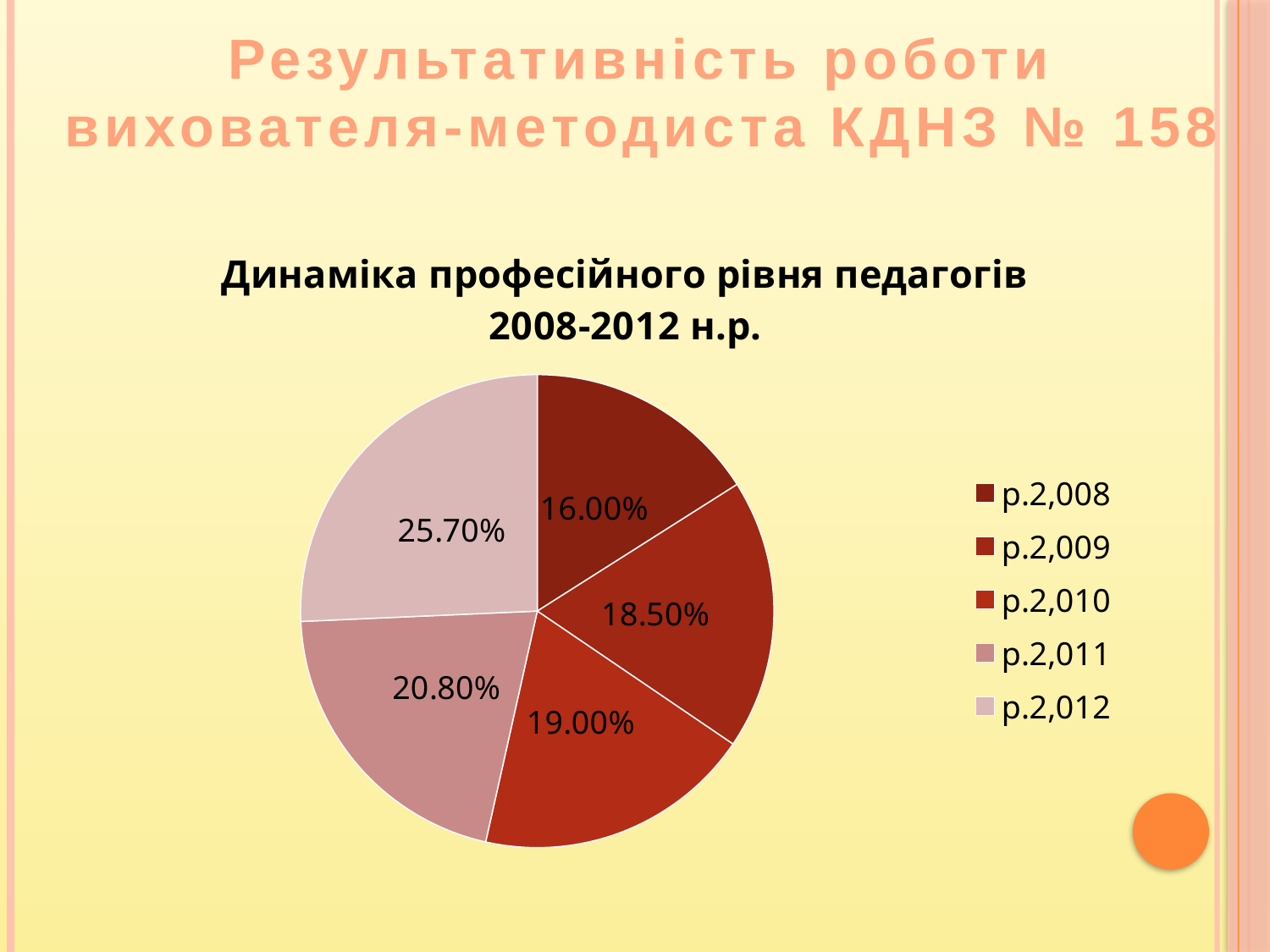
What kind of chart is shown on the slide? pie chart What is the value for р.2,011 in the pie chart? 20.80% What is the value for р.2,012 in the pie chart? 25.70% Which category has the largest slice of the pie chart? р.2,012 What is the difference between the values for р.2,012 and р.2,008? 9.70% Which is larger, the value for р.2,011 or the value for р.2,009? р.2,011 How many entries does the legend of the pie chart list? 5 What is the title of the pie chart? Динаміка професійного рівня педагогів 2008-2012 н.р. Which category has the smallest slice of the pie chart? р.2,008 What is the value for р.2,010 in the pie chart? 19.00% What is the value for р.2,008 in the pie chart? 16.00% How many slices does the pie chart have? 5